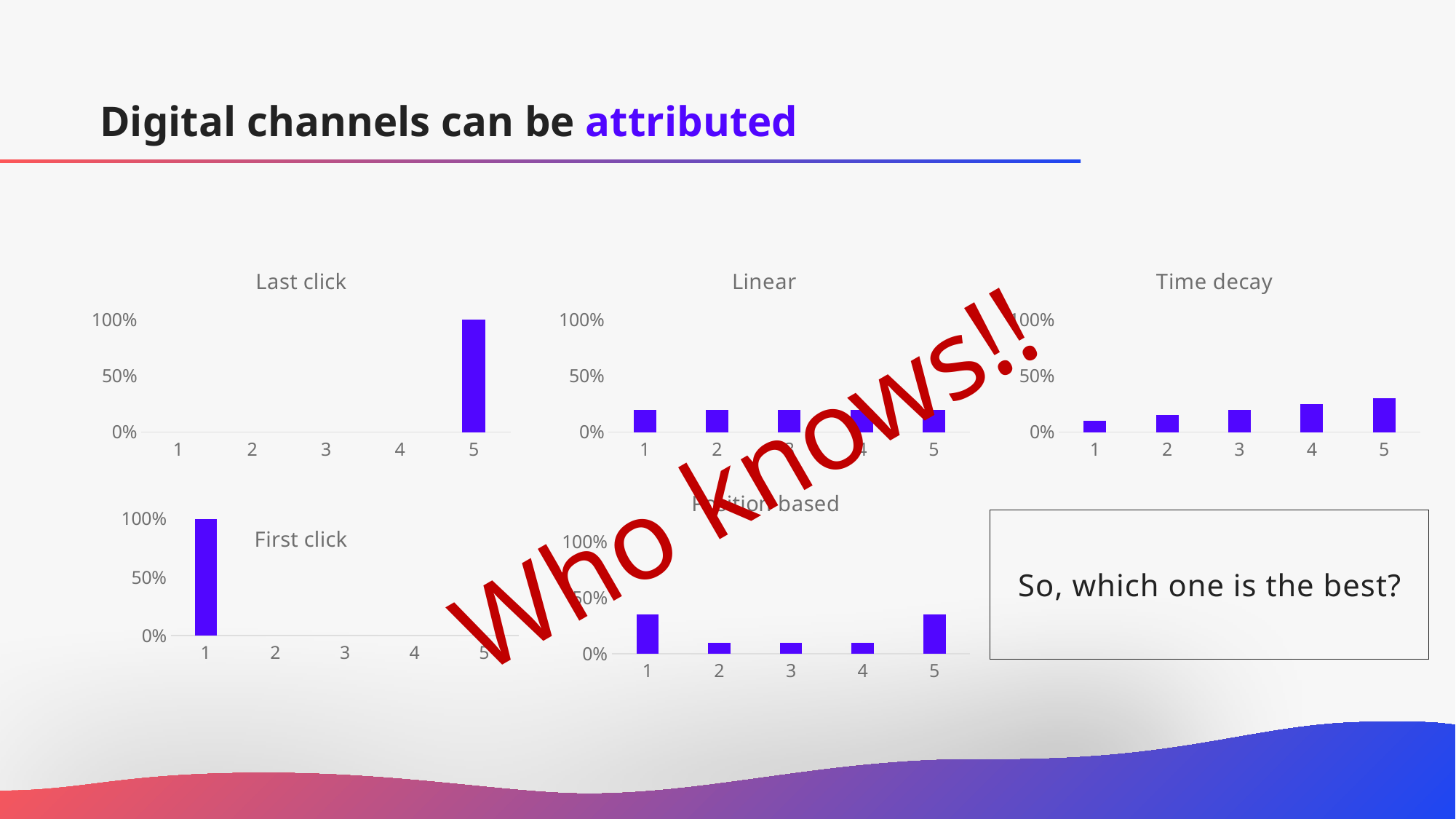
In the Last click chart, what is the value for category 5? 100% In the First click chart, what is the value for category 1? 100% What kind of chart is the Last click chart? bar chart In the Position based chart, which has the larger value, category 1 or category 2? category 1 How many categories are shown on the x axis of the Linear chart? 5 In the Last click chart, is the value for category 5 greater or less than 50%? greater How many charts are shown on the slide? 5 In the Time decay chart, is the value for category 5 greater or less than 50%? less In the Time decay chart, which category has the lowest value? 1 In the Position based chart, is the value for category 1 greater or less than 50%? less In the Time decay chart, which category has the highest value? 5 In the Time decay chart, do the values rise or fall from category 1 to category 5? rise